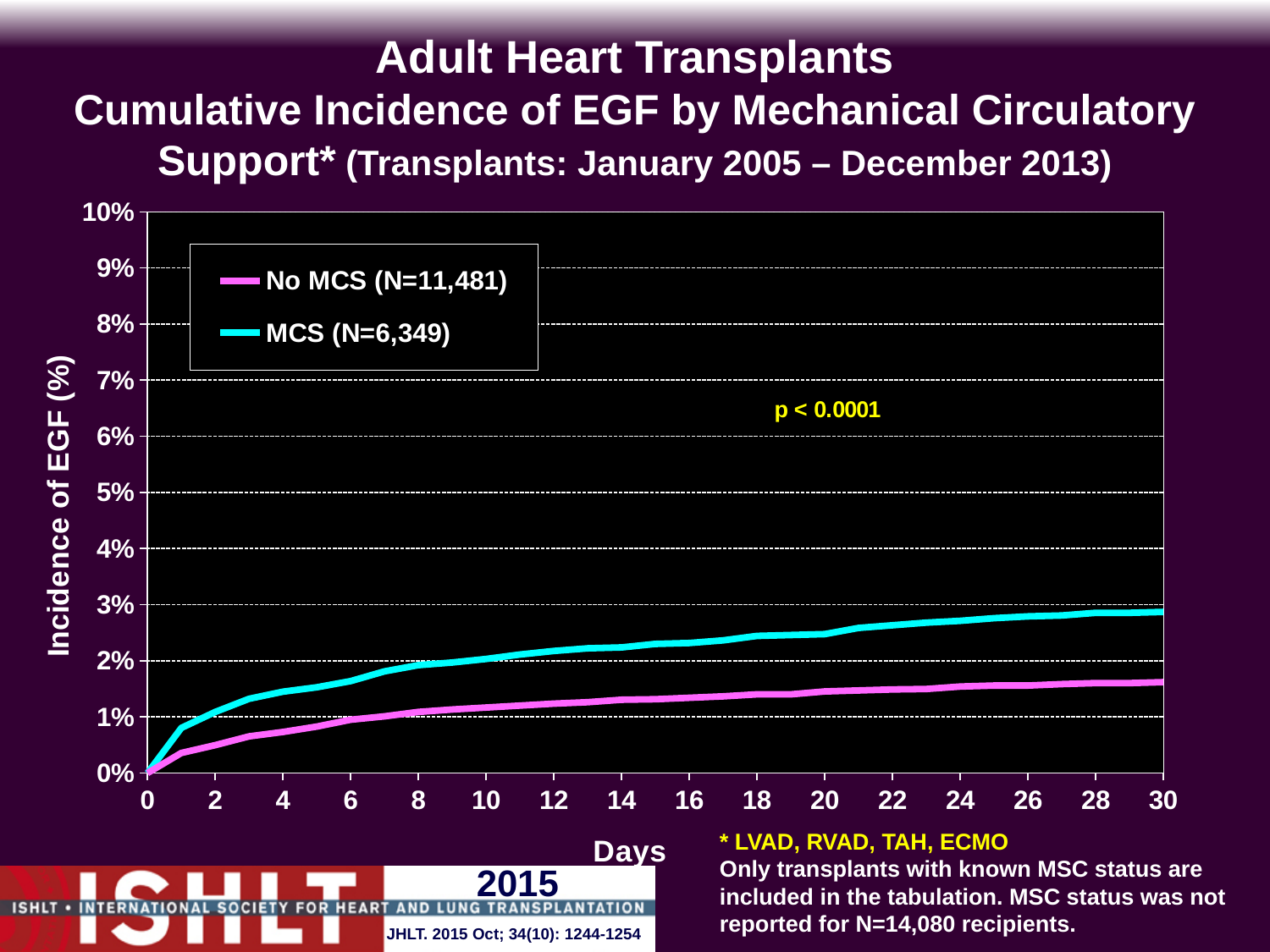
Is the value for the MCS series at day 30 greater or less than 3%? less What is the N shown in the legend for the No MCS series? N=11,481 Is the value for the No MCS series at day 30 greater or less than 1%? greater How many series does the legend list? 2 Which series has the higher cumulative incidence of EGF at day 30, MCS or No MCS? MCS Is the value for the MCS series at day 30 greater or less than 2%? greater Do the values for the No MCS series rise or fall as days increase from 0 to 30? rise What p-value is printed on the chart? p < 0.0001 What kind of chart is shown on the slide? line chart Do the values for the MCS series rise or fall as days increase from 0 to 30? rise